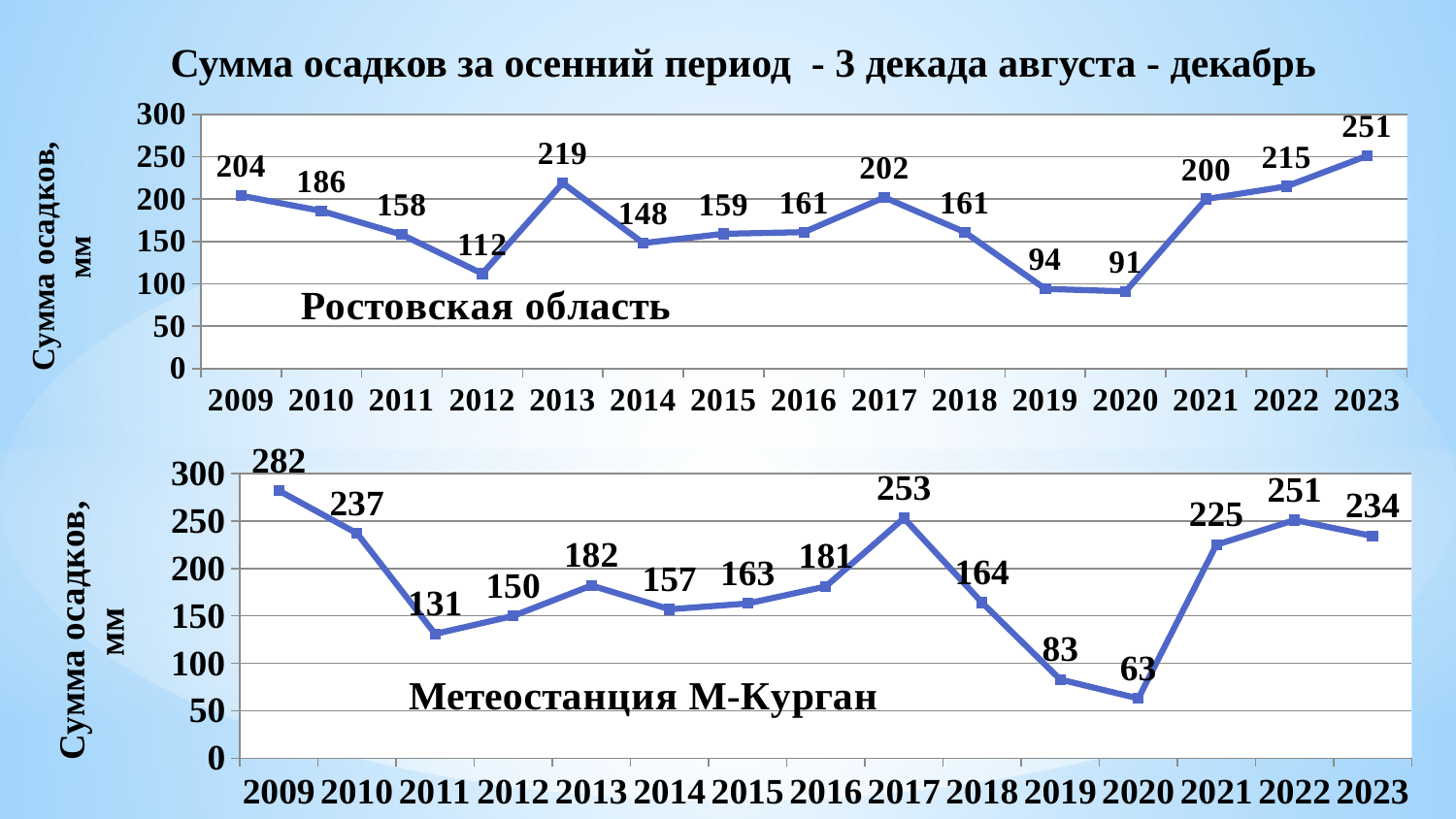
How many years are plotted in the bottom chart (Метеостанция М-Курган)? 15 What kind of chart is the top chart (Ростовская область)? line chart In the top chart (Ростовская область), what is the difference between the values for 2013 and 2014? 71 In the bottom chart (Метеостанция М-Курган), do the values rise or fall from 2020 to 2022? rise What is the y-axis label of the charts on the slide? Сумма осадков, мм In the bottom chart (Метеостанция М-Курган), which is larger, the value for 2017 or the value for 2022? 2017 In the top chart (Ростовская область), what is the precipitation value for 2013? 219 In the top chart (Ростовская область), which year has the highest value? 2023 In the top chart (Ростовская область), what is the difference between the values for 2023 and 2020? 160 In the top chart (Ростовская область), is the value for 2012 greater or less than 150? less In the bottom chart (Метеостанция М-Курган), which year has the lowest value? 2020 In the bottom chart (Метеостанция М-Курган), what is the precipitation value for 2009? 282